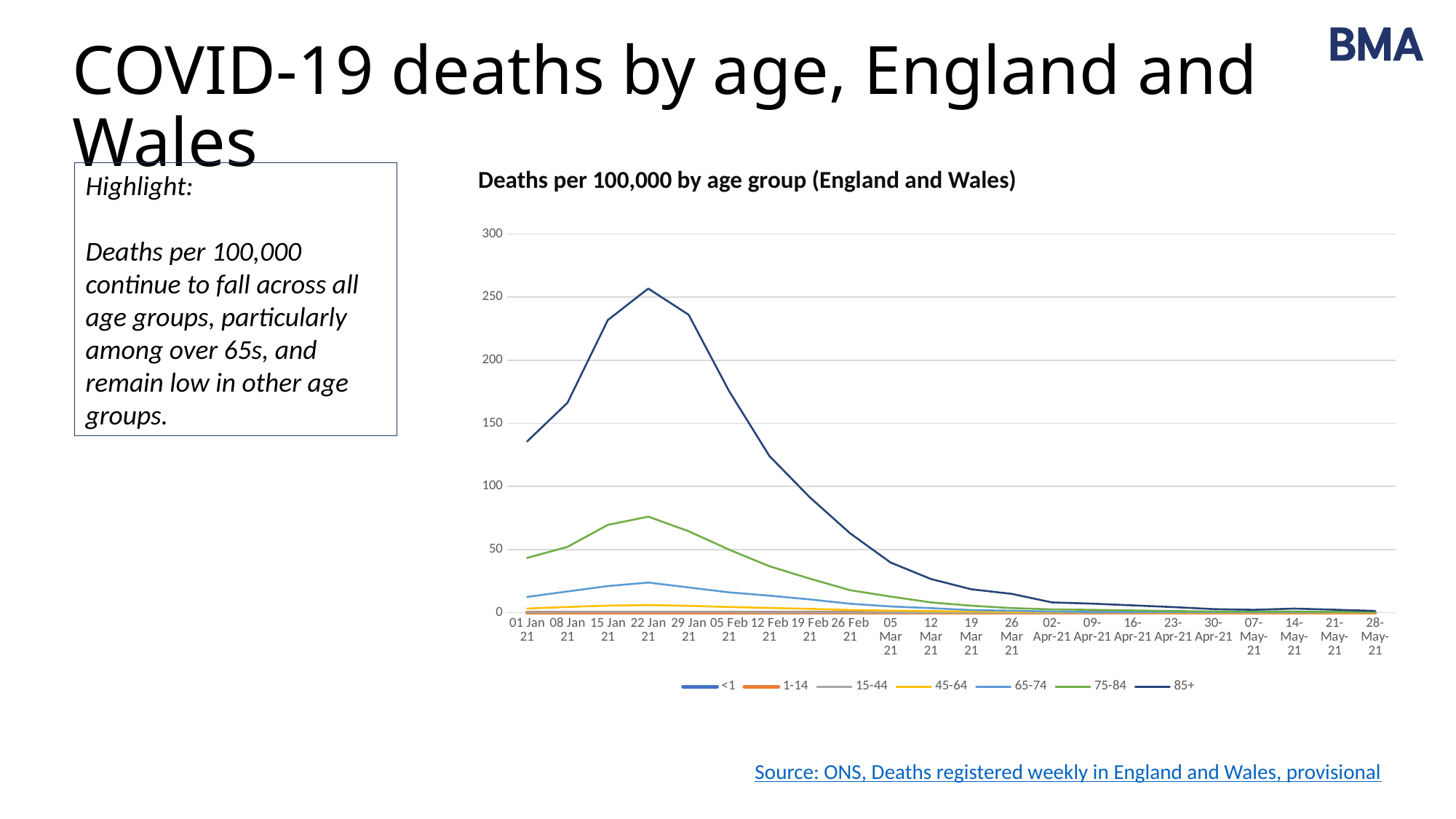
Which is larger on 22 Jan 21, the value for 75-84 or the value for 65-74? 75-84 How many dates are shown along the x axis? 22 Is the value for 75-84 on 22 Jan 21 greater or less than 100? less Is the value for 85+ on 05 Mar 21 greater or less than 50? less How many series does the legend list? 7 What kind of chart is shown on the slide? line chart Is the value for 85+ on 01 Jan 21 greater or less than 150? less On which date does the 85+ series reach its peak? 22 Jan 21 Which age group has the highest deaths per 100,000 on 22 Jan 21? 85+ Do the values for 85+ rise or fall between 22 Jan 21 and 28-May-21? fall What is the title of the chart? Deaths per 100,000 by age group (England and Wales)